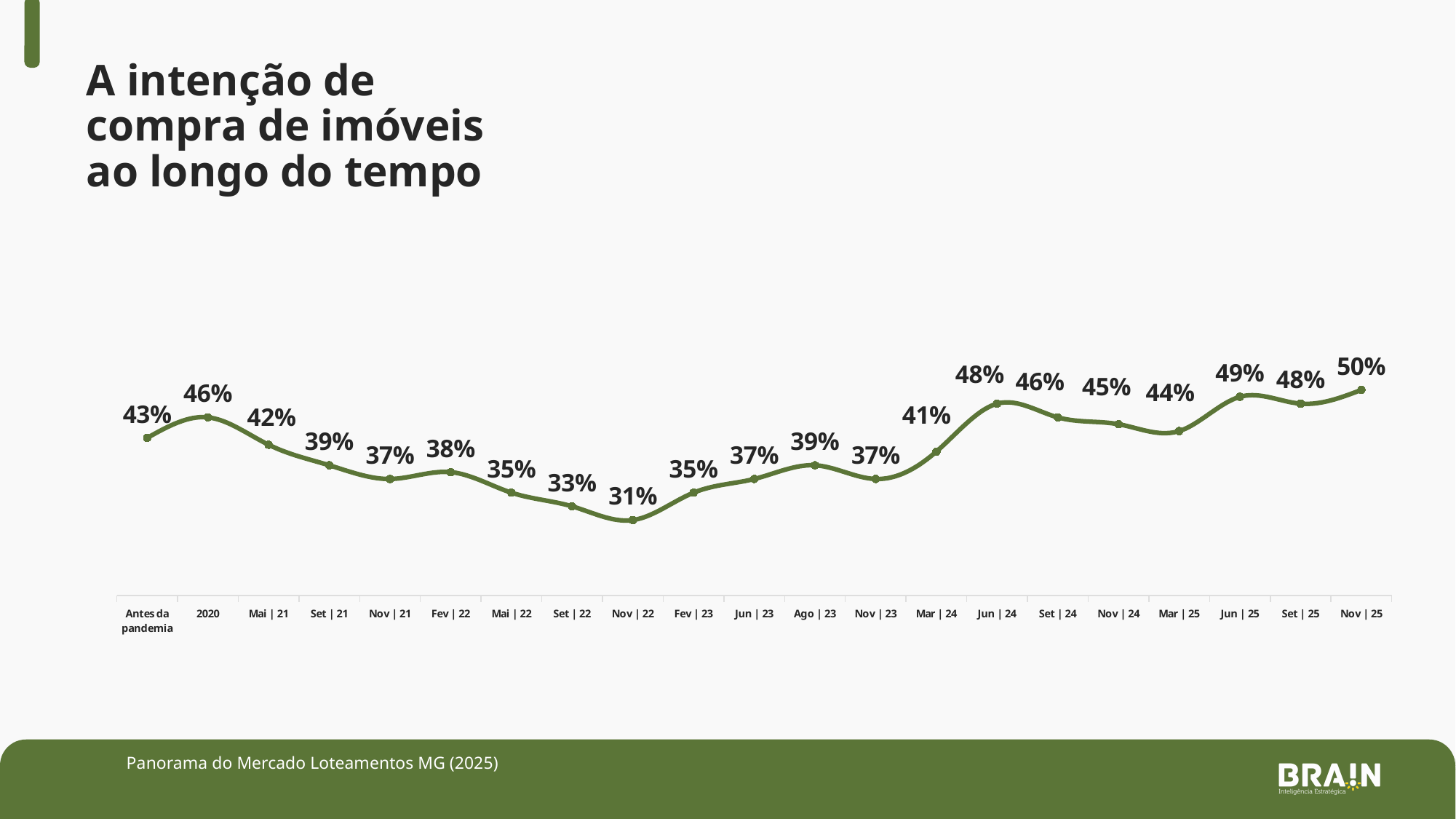
What is the value for Nov | 25? 50% What is the title of the chart? A intenção de compra de imóveis ao longo do tempo What is the value for Antes da pandemia? 43% Which period has the lowest value? Nov | 22 What is the value for Nov | 22? 31% What kind of chart is shown on the slide? Line chart What is the value for Jun | 24? 48% What is the difference between the values for Nov | 25 and Nov | 22? 19% Which is larger, the value for Jun | 25 or the value for Set | 25? Jun | 25 Which period has the highest value? Nov | 25 What is the difference between the values for 2020 and Mai | 21? 4% How many data points are plotted on the chart? 21